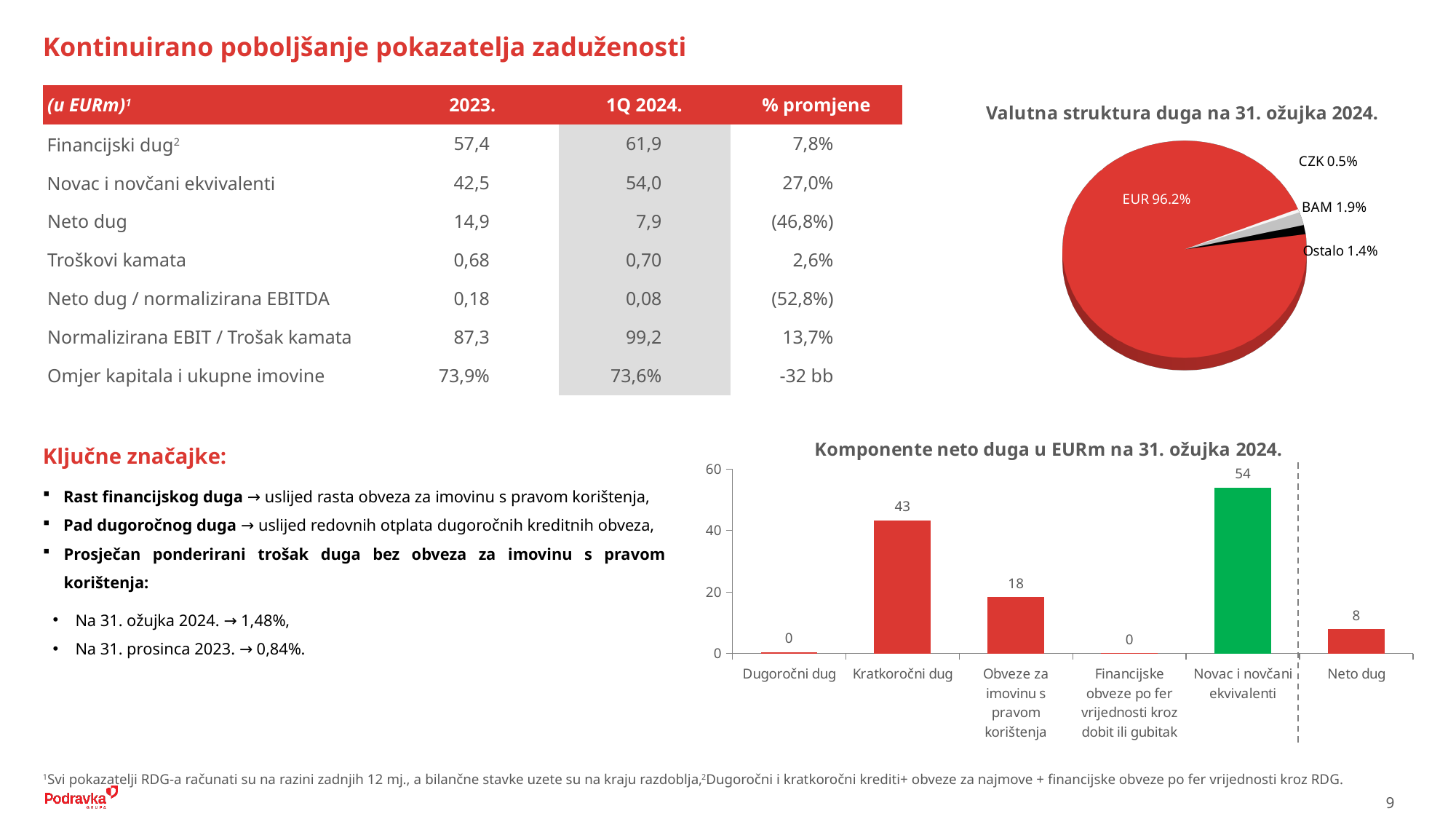
How many categories are shown on the x axis of the chart 'Komponente neto duga u EURm na 31. ožujka 2024.'? 6 In the chart 'Komponente neto duga u EURm na 31. ožujka 2024.', which is larger: Kratkoročni dug or Obveze za imovinu s pravom korištenja? Kratkoročni dug In the chart 'Komponente neto duga u EURm na 31. ožujka 2024.', what is the value for Novac i novčani ekvivalenti? 54 In the chart 'Komponente neto duga u EURm na 31. ožujka 2024.', which bar is coloured green? Novac i novčani ekvivalenti What kind of chart is 'Komponente neto duga u EURm na 31. ožujka 2024.'? Bar chart In the pie chart 'Valutna struktura duga na 31. ožujka 2024.', what share does EUR have? 96.2% How many slices does the pie chart 'Valutna struktura duga na 31. ožujka 2024.' have? 4 In the chart 'Komponente neto duga u EURm na 31. ožujka 2024.', which category has the highest value? Novac i novčani ekvivalenti In the chart 'Komponente neto duga u EURm na 31. ožujka 2024.', what is the difference between Novac i novčani ekvivalenti and Kratkoročni dug? 11 In the chart 'Komponente neto duga u EURm na 31. ožujka 2024.', what is the value for Kratkoročni dug? 43 In the pie chart 'Valutna struktura duga na 31. ožujka 2024.', which currency has the smallest share? CZK In the chart 'Komponente neto duga u EURm na 31. ožujka 2024.', what is the value for Neto dug? 8